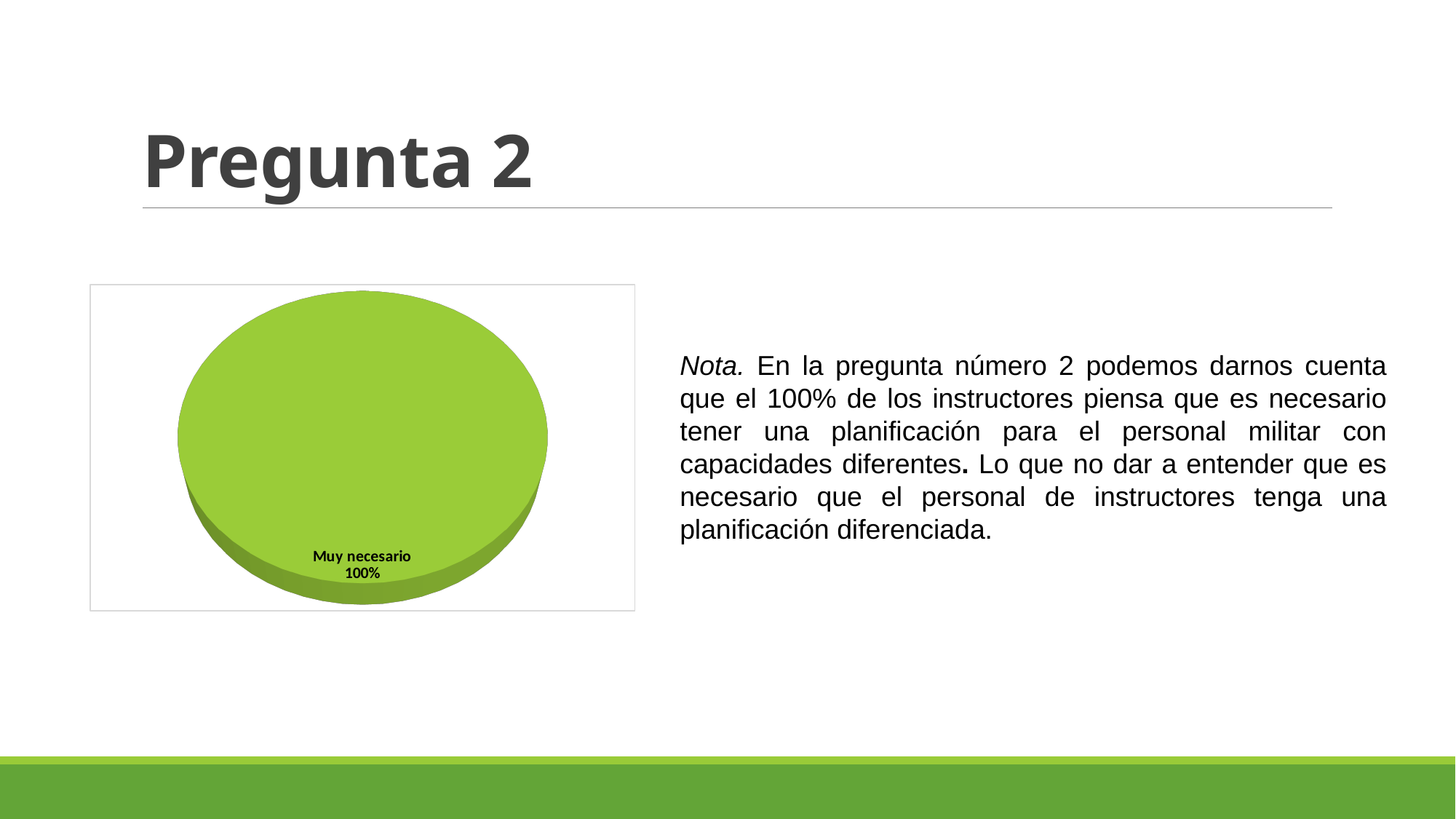
Which category is the largest in the pie chart? Muy necesario What is the label of the only slice in the pie chart? Muy necesario What is the value shown for "Muy necesario" in the pie chart? 100% How many slices does the pie chart have? 1 What share of the pie does the "Muy necesario" slice represent? 100% What colour is the slice in the pie chart? Green Is the value for "Muy necesario" greater or less than 50%? greater What kind of chart is shown on the slide? Pie chart